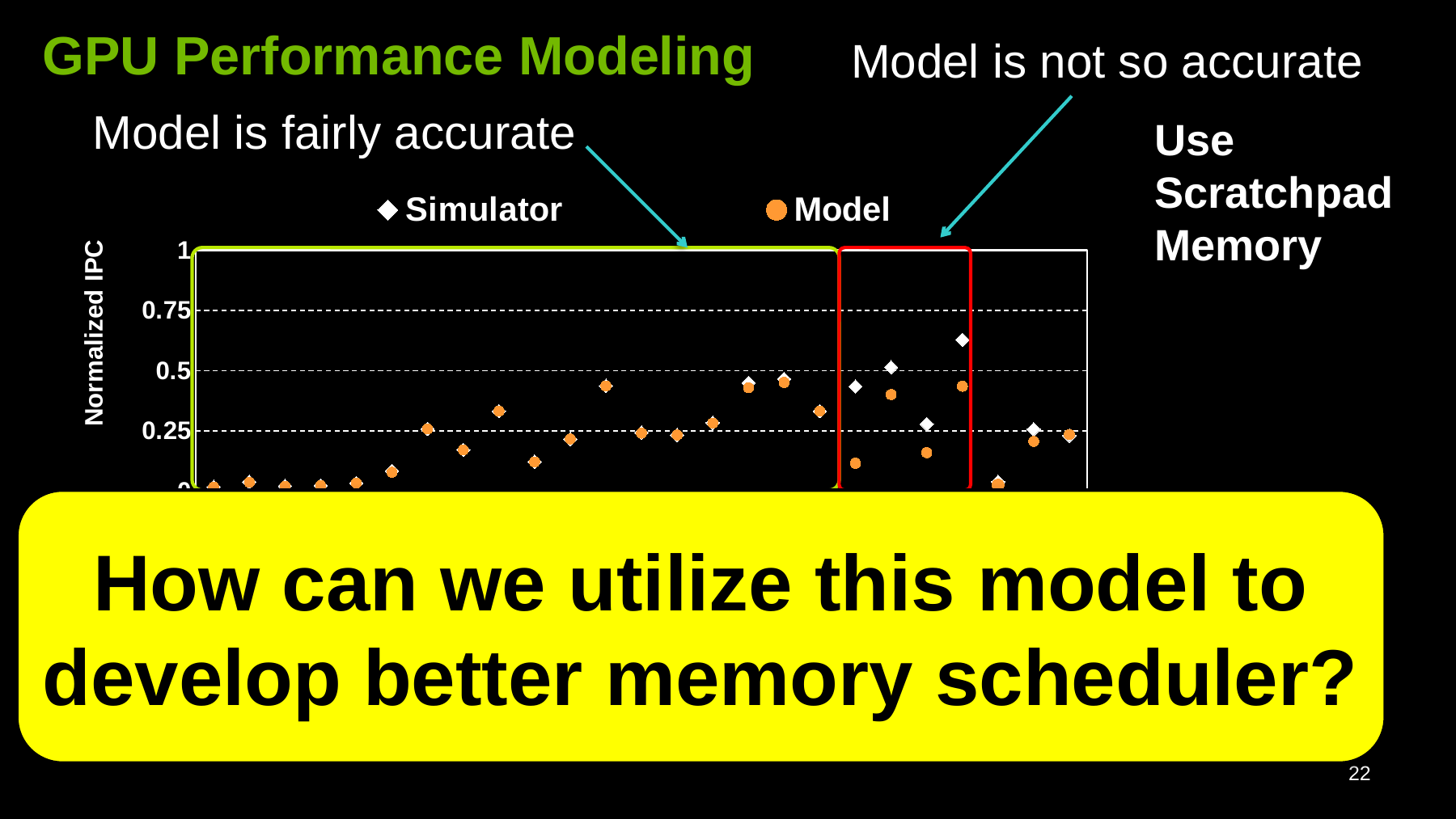
Within the green-outlined region of the chart, do the plotted values generally rise or fall from left to right? rise Is the highest Model value on the chart greater or less than 0.25? greater What is the label on the chart's vertical axis? Normalized IPC What are the two series named in the chart legend? Simulator and Model Is the highest Model value on the chart greater or less than 0.75? less How many series does the chart legend list? 2 Is the highest Simulator value on the chart greater or less than 0.5? greater What kind of chart is shown on the slide? scatter chart